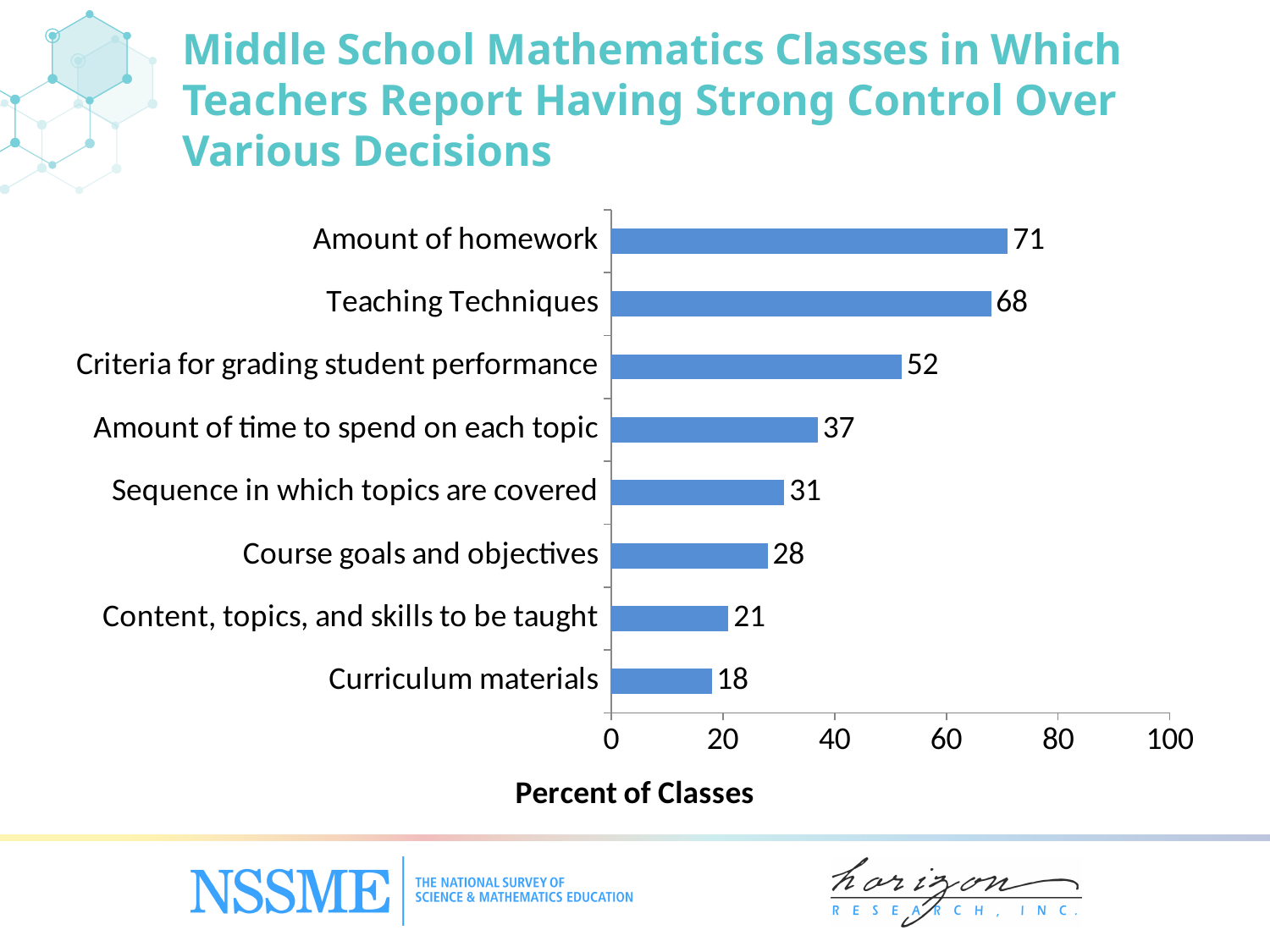
What is the value for Curriculum materials? 18 What is the difference between the values for Amount of homework and Teaching Techniques? 3 What kind of chart is shown on the slide? Bar chart Which is larger, the value for Course goals and objectives or the value for Content, topics, and skills to be taught? Course goals and objectives What is the value for Criteria for grading student performance? 52 What is the difference between the values for Amount of time to spend on each topic and Sequence in which topics are covered? 6 Which category has the lowest value? Curriculum materials Which category has the highest value? Amount of homework What is the label of the horizontal axis? Percent of Classes What percent of classes is shown for Amount of homework? 71 Is the value for Criteria for grading student performance greater or less than 40? greater How many categories are shown in the chart? 8